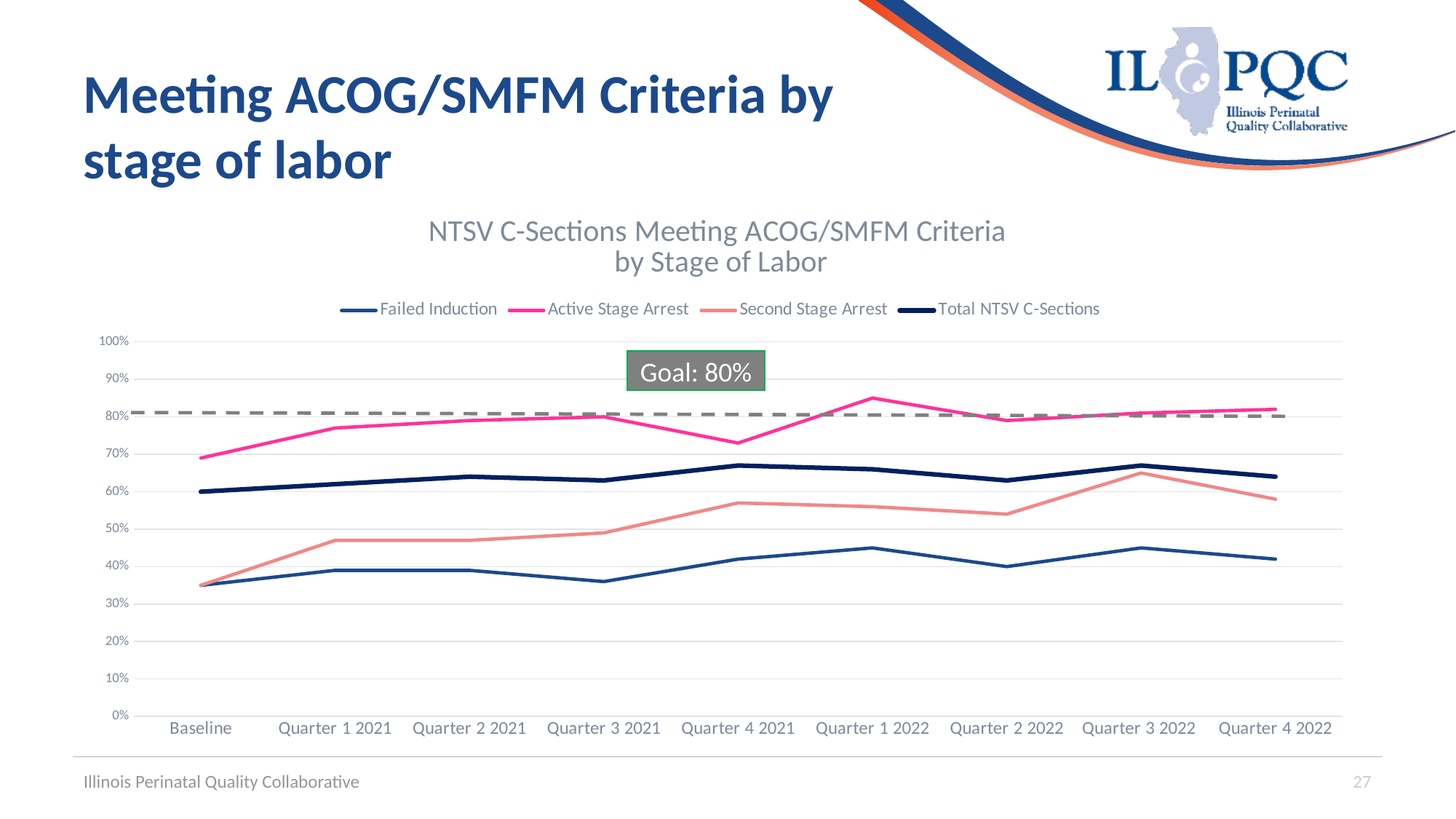
At Baseline, which is higher: Active Stage Arrest or Total NTSV C-Sections? Active Stage Arrest At which time point does Active Stage Arrest reach its highest value? Quarter 1 2022 What kind of chart is shown on the slide? Line chart Which series is drawn in pink? Active Stage Arrest Is the value for Second Stage Arrest at Quarter 3 2022 greater or less than 60%? greater How many series does the legend list? 4 Is the value for Failed Induction at Baseline greater or less than 40%? less Which series has the lowest value at Quarter 2 2021? Failed Induction What goal value is marked on the chart? 80% Is the value for Active Stage Arrest at Quarter 1 2022 greater or less than 80%? greater How many time points are shown along the x axis? 9